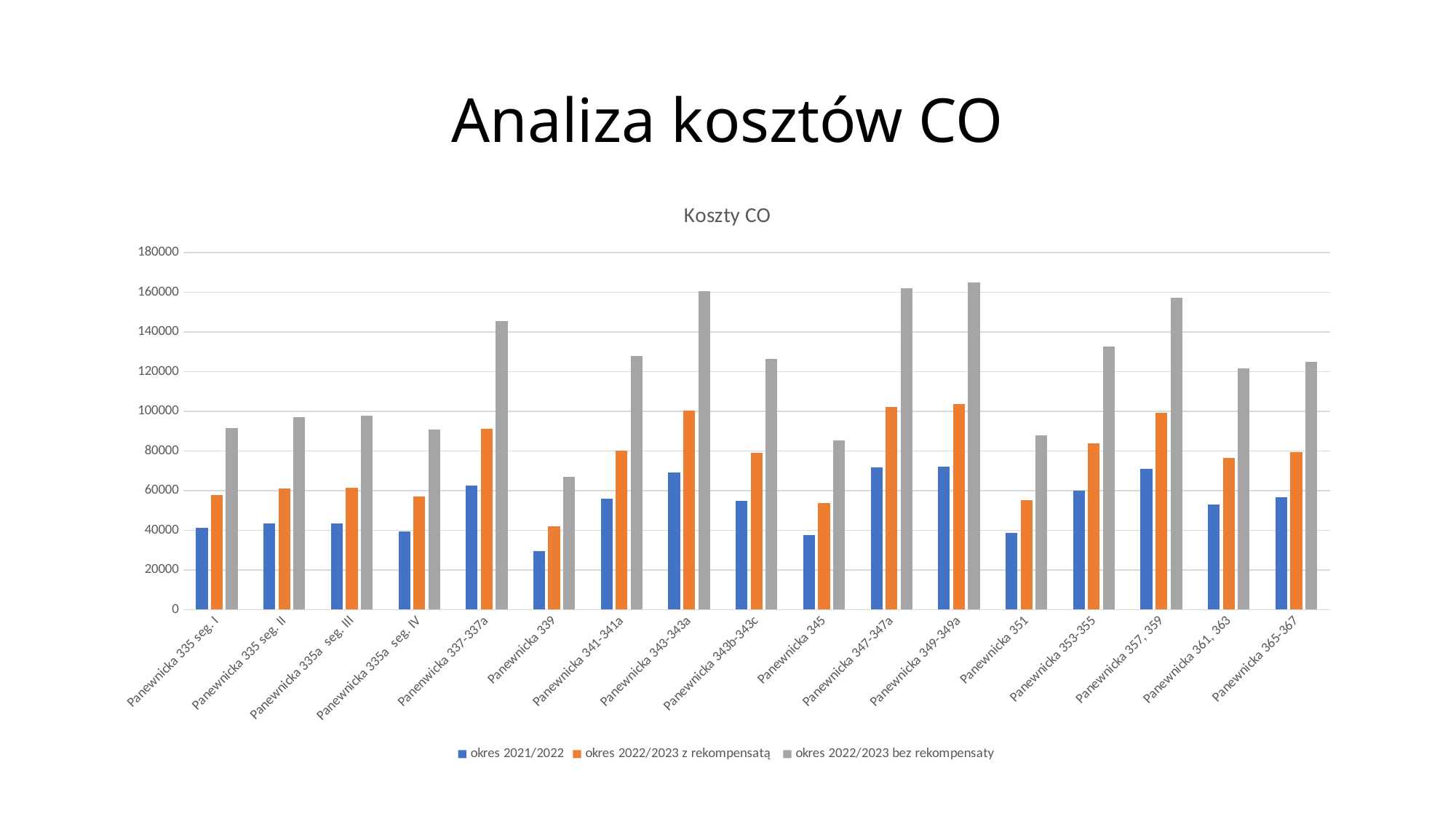
How many series does the legend of the chart list? 3 Is the value for Panewnicka 335 seg. I in the series okres 2021/2022 greater or less than 60000? less Which category has the lowest value for the series okres 2022/2023 bez rekompensaty? Panewnicka 339 Is the value for Panewnicka 339 in the series okres 2022/2023 bez rekompensaty greater or less than 80000? less How many categories (addresses) are shown on the x axis of the chart? 17 What is the title of the chart? Koszty CO Which series is shown in grey in the chart? okres 2022/2023 bez rekompensaty In the series okres 2021/2022, which is larger: Panewnicka 343-343a or Panewnicka 345? Panewnicka 343-343a In the series okres 2022/2023 bez rekompensaty, which is larger: Panewnicka 337-337a or Panewnicka 341-341a? Panewnicka 337-337a Is the value for Panewnicka 343-343a in the series okres 2022/2023 bez rekompensaty greater or less than 140000? greater Which category has the lowest value for the series okres 2021/2022? Panewnicka 339 What kind of chart is shown on the slide? bar chart